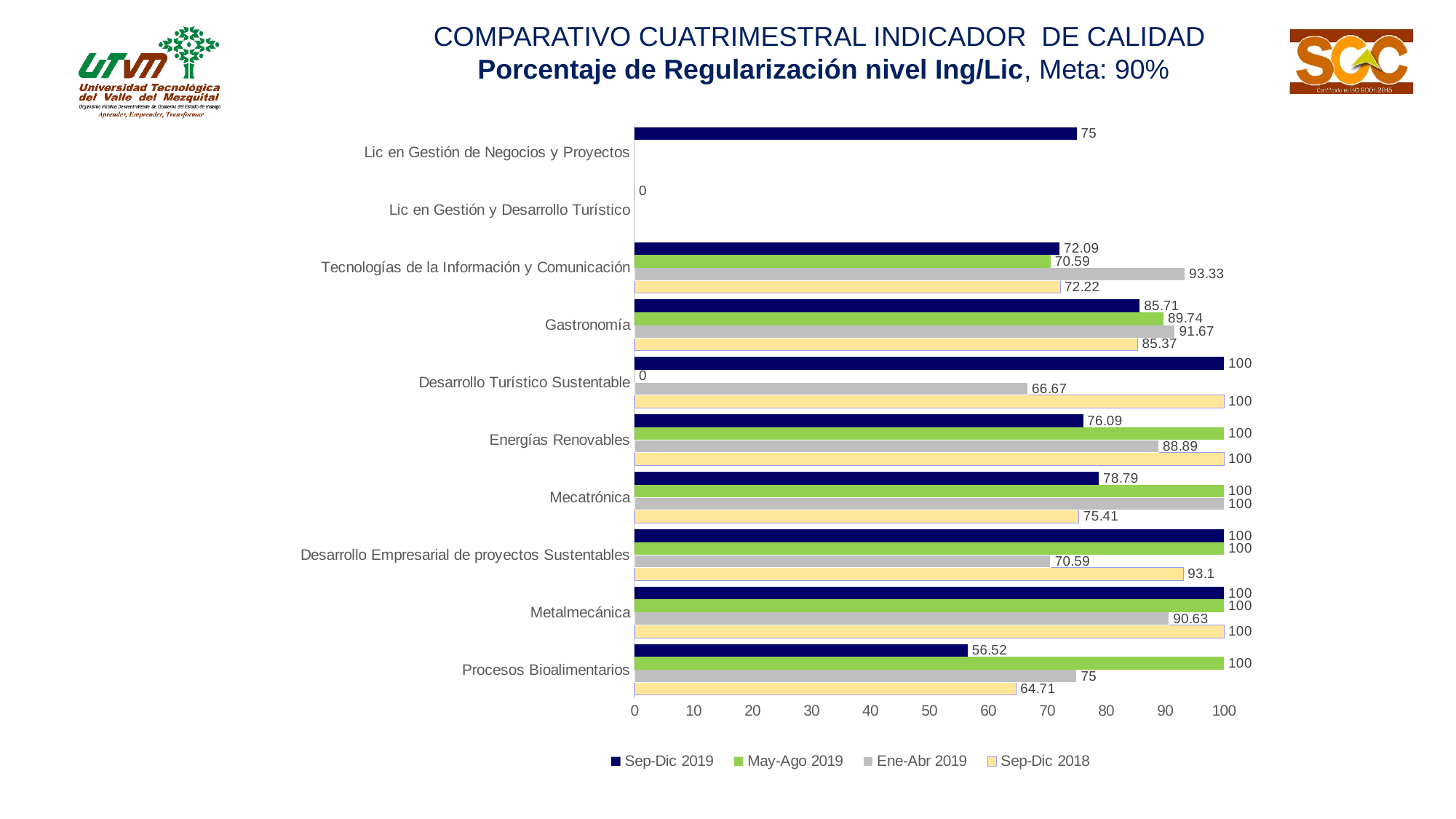
What is the Sep-Dic 2019 value for Procesos Bioalimentarios? 56.52 How many series does the legend list? 4 What is the May-Ago 2019 value for Gastronomía? 89.74 How many categories (programs) are shown on the chart? 10 What is the difference between the Ene-Abr 2019 and May-Ago 2019 values for Desarrollo Turístico Sustentable? 66.67 Which category has the lowest Sep-Dic 2019 value? Lic en Gestión y Desarrollo Turístico What type of chart is shown on the slide? bar chart What is the difference between the Ene-Abr 2019 and Sep-Dic 2018 values for Procesos Bioalimentarios? 10.29 For Mecatrónica, which is larger: the Sep-Dic 2019 value or the Sep-Dic 2018 value? Sep-Dic 2019 What is the Sep-Dic 2018 value for Desarrollo Empresarial de proyectos Sustentables? 93.1 What target (Meta) is stated in the chart title? 90% What is the Ene-Abr 2019 value for Tecnologías de la Información y Comunicación? 93.33